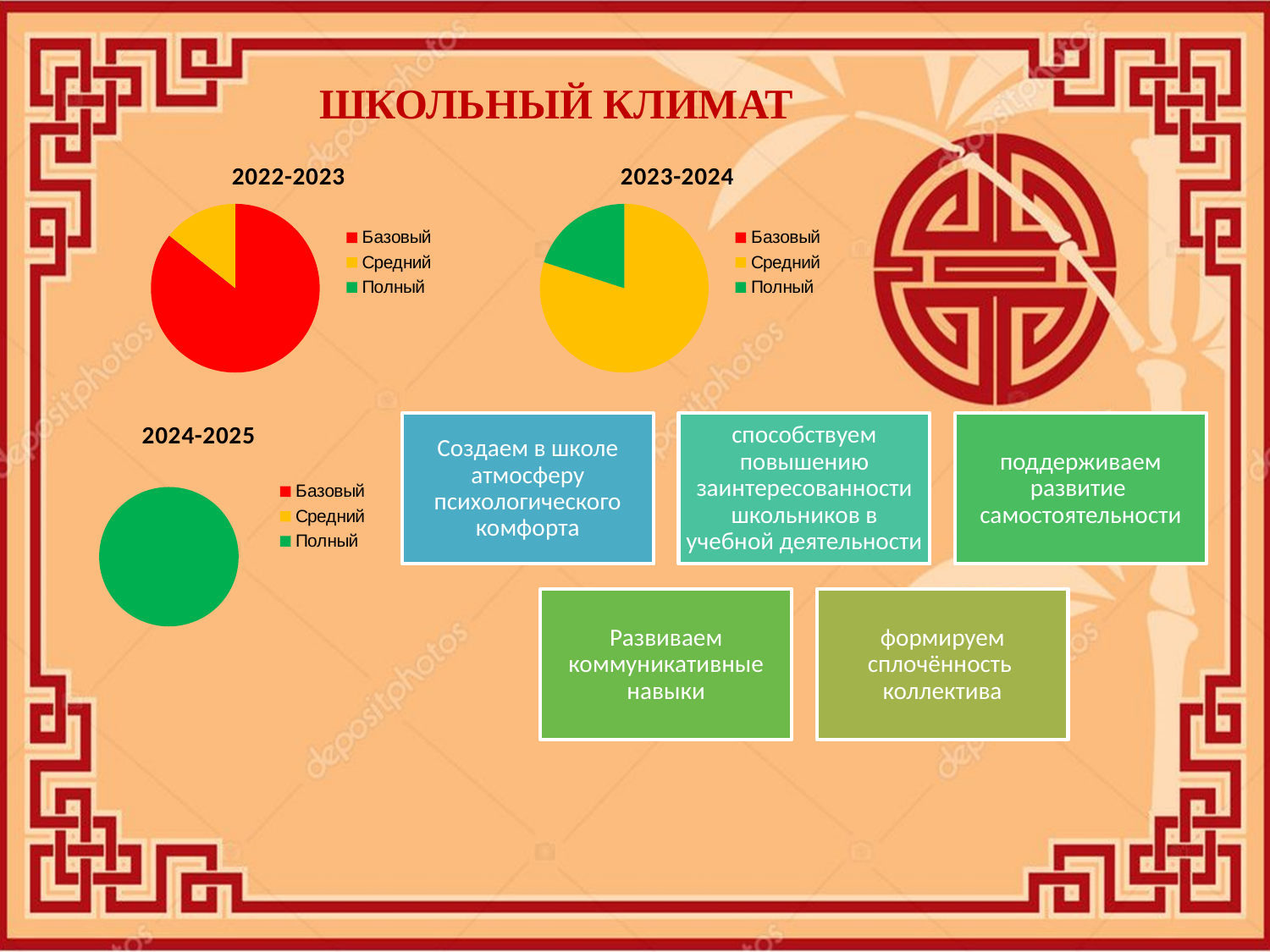
How many pie charts are shown on the slide? 3 In the 2023-2024 chart, which category has the largest slice? Средний In the 2022-2023 chart, which category has the smallest visible slice? Средний In the 2024-2025 chart, which category has the largest slice? Полный In the legend of the 2024-2025 chart, which colour represents Полный? green What is the title of the slide above the charts? ШКОЛЬНЫЙ КЛИМАТ In the 2022-2023 chart, which is larger, Базовый or Средний? Базовый In the 2023-2024 chart, which is larger, Средний or Полный? Средний What kind of chart is the 2022-2023 chart? pie chart In the 2023-2024 chart, which category has the smallest visible slice? Полный In the 2022-2023 chart, which category has the largest slice? Базовый How many entries does the legend of the 2023-2024 chart list? 3